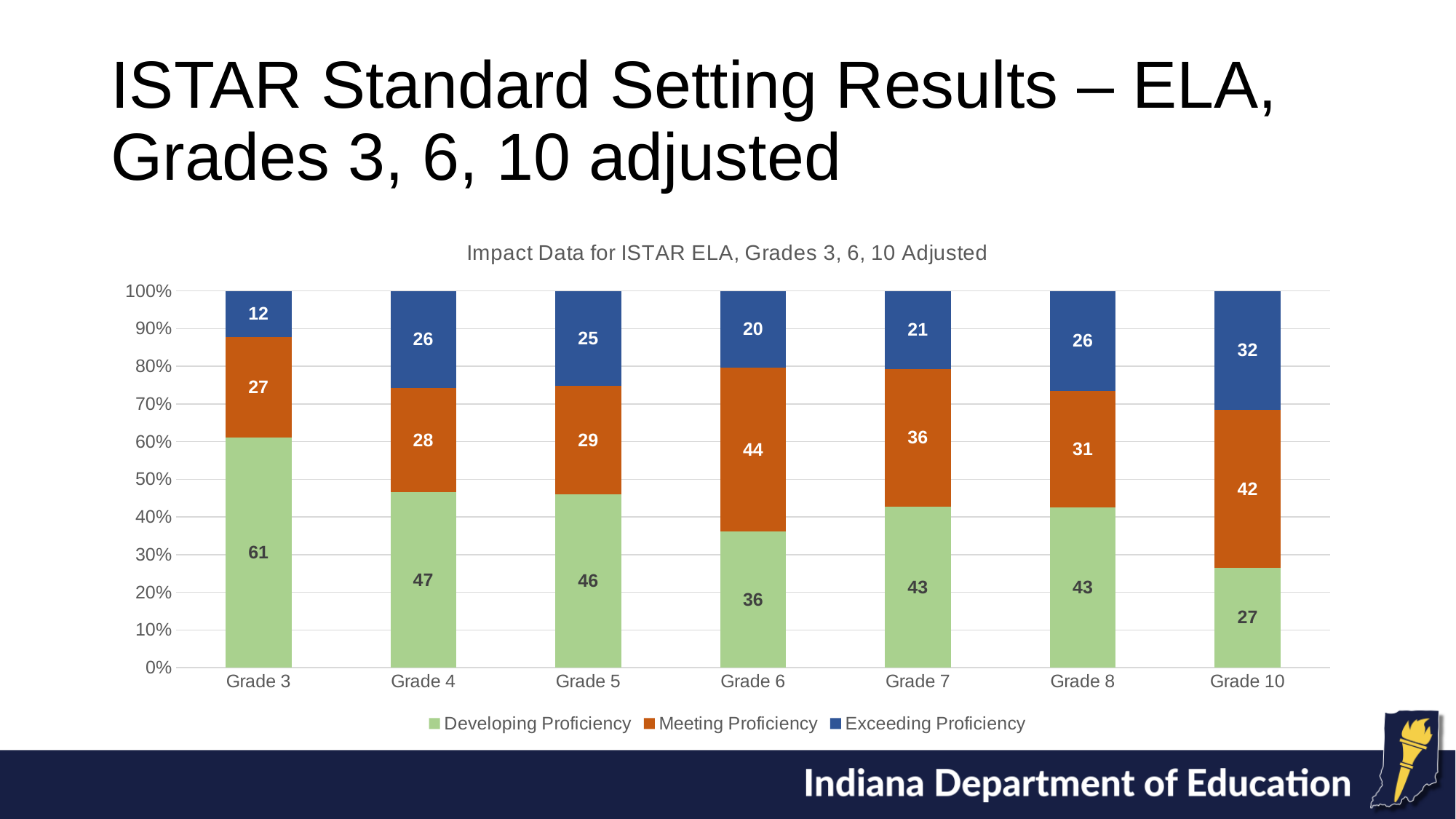
What is the title of the chart? Impact Data for ISTAR ELA, Grades 3, 6, 10 Adjusted What is the Exceeding Proficiency value for Grade 10? 32 How many grades are shown on the x axis? 7 Which grade has the lowest Exceeding Proficiency value? Grade 3 Which is larger, the Developing Proficiency value for Grade 4 or for Grade 6? Grade 4 Do the Developing Proficiency values generally rise or fall from Grade 3 to Grade 10? Fall What is the Developing Proficiency value for Grade 3? 61 What kind of chart is shown on the slide? Stacked bar chart How many series does the legend list? 3 What is the Meeting Proficiency value for Grade 6? 44 What is the difference between the Meeting Proficiency values for Grade 10 and Grade 3? 15 Which grade has the highest Developing Proficiency value? Grade 3